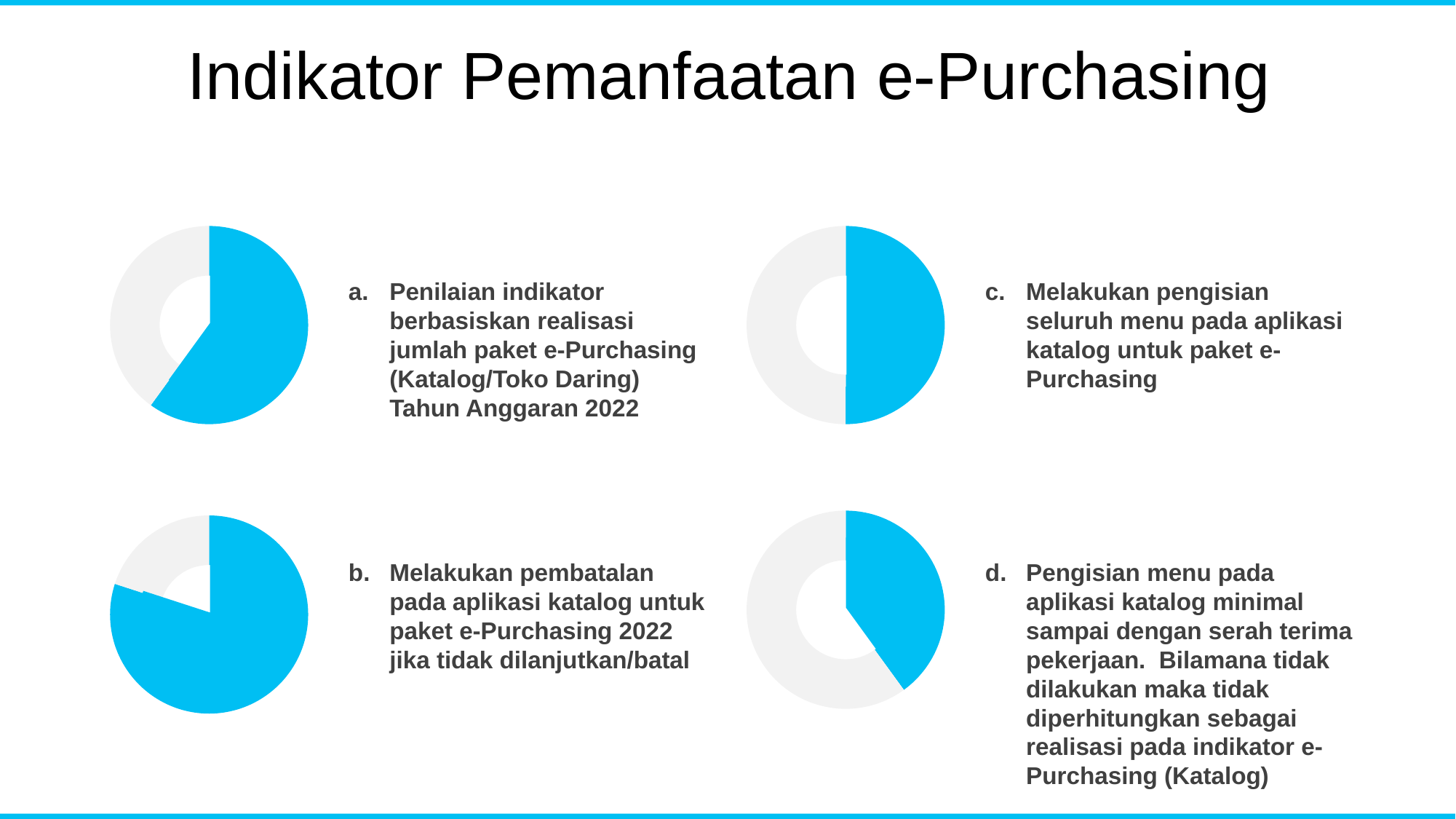
What kind of chart is shown next to item a on the slide? Pie chart (doughnut) Is the blue portion larger in the pie chart next to item b or in the pie chart next to item c? b How many pie charts are shown on the slide? 4 Do the pie charts on the slide show any data labels or a legend? No Is the blue portion larger in the pie chart next to item a or in the pie chart next to item d? a Which pie chart on the slide has the largest blue portion: the one next to item a, b, c, or d? b Which pie chart on the slide has the smallest blue portion: the one next to item a, b, c, or d? d What colour is the filled (highlighted) portion of each pie chart on the slide? Blue